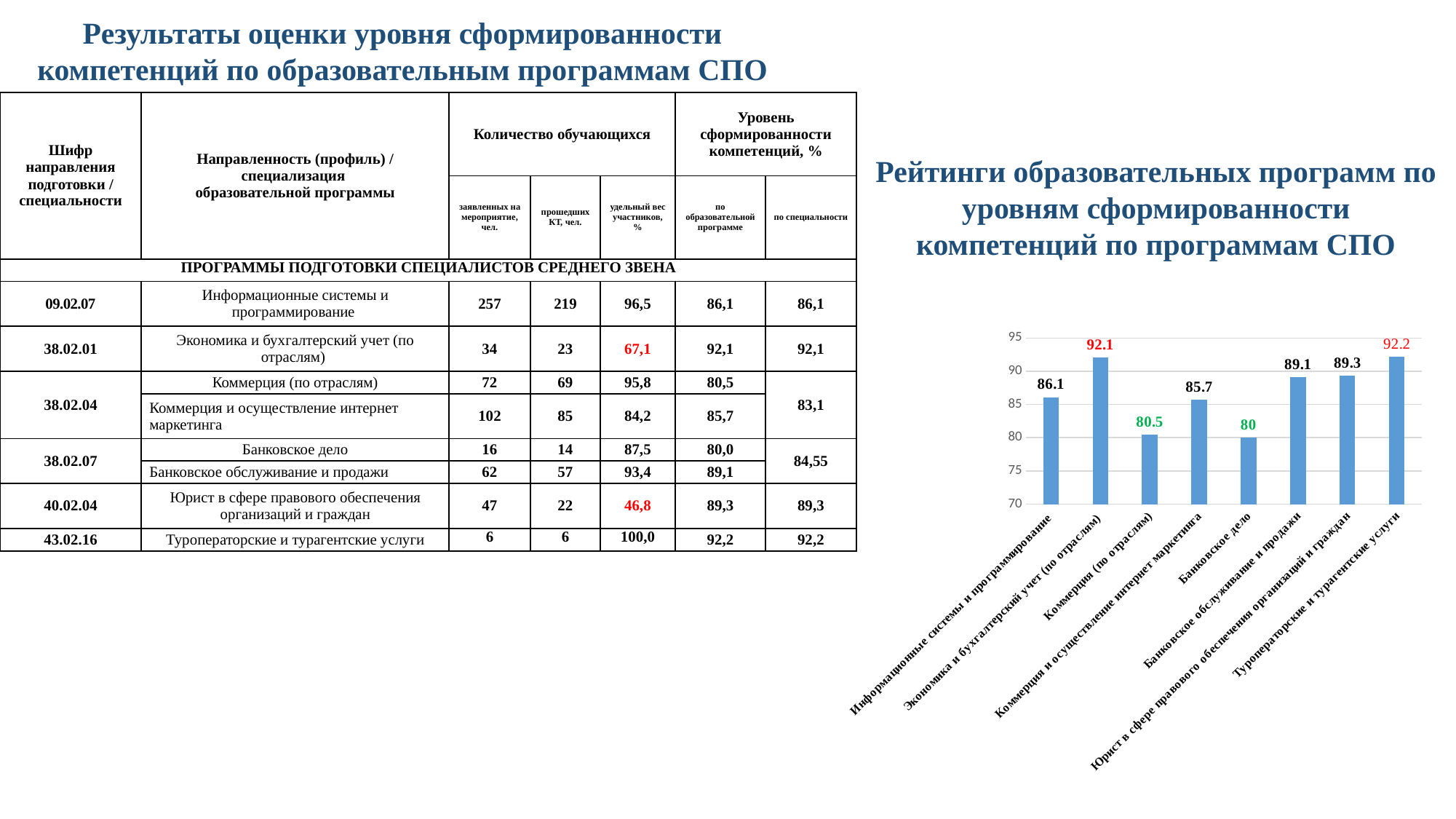
What kind of chart is shown on the slide? bar chart What is the value for Банковское дело in the chart? 80 What is the difference between the values for Экономика и бухгалтерский учет (по отраслям) and Коммерция (по отраслям)? 11.6 What is the value for Коммерция (по отраслям) in the chart? 80.5 Which category has the lowest value in the chart? Банковское дело What is the value for Юрист в сфере правового обеспечения организаций и граждан in the chart? 89.3 Which category has the highest value in the chart? Туроператорские и турагентские услуги What is the value for Информационные системы и программирование in the chart? 86.1 How many bars (categories) does the chart show? 8 What is the title of the chart on the right side of the slide? Рейтинги образовательных программ по уровням сформированности компетенций по программам СПО Is the value for Коммерция и осуществление интернет маркетинга greater or less than 85? greater Which is larger: the value for Банковское обслуживание и продажи or the value for Коммерция и осуществление интернет маркетинга? Банковское обслуживание и продажи